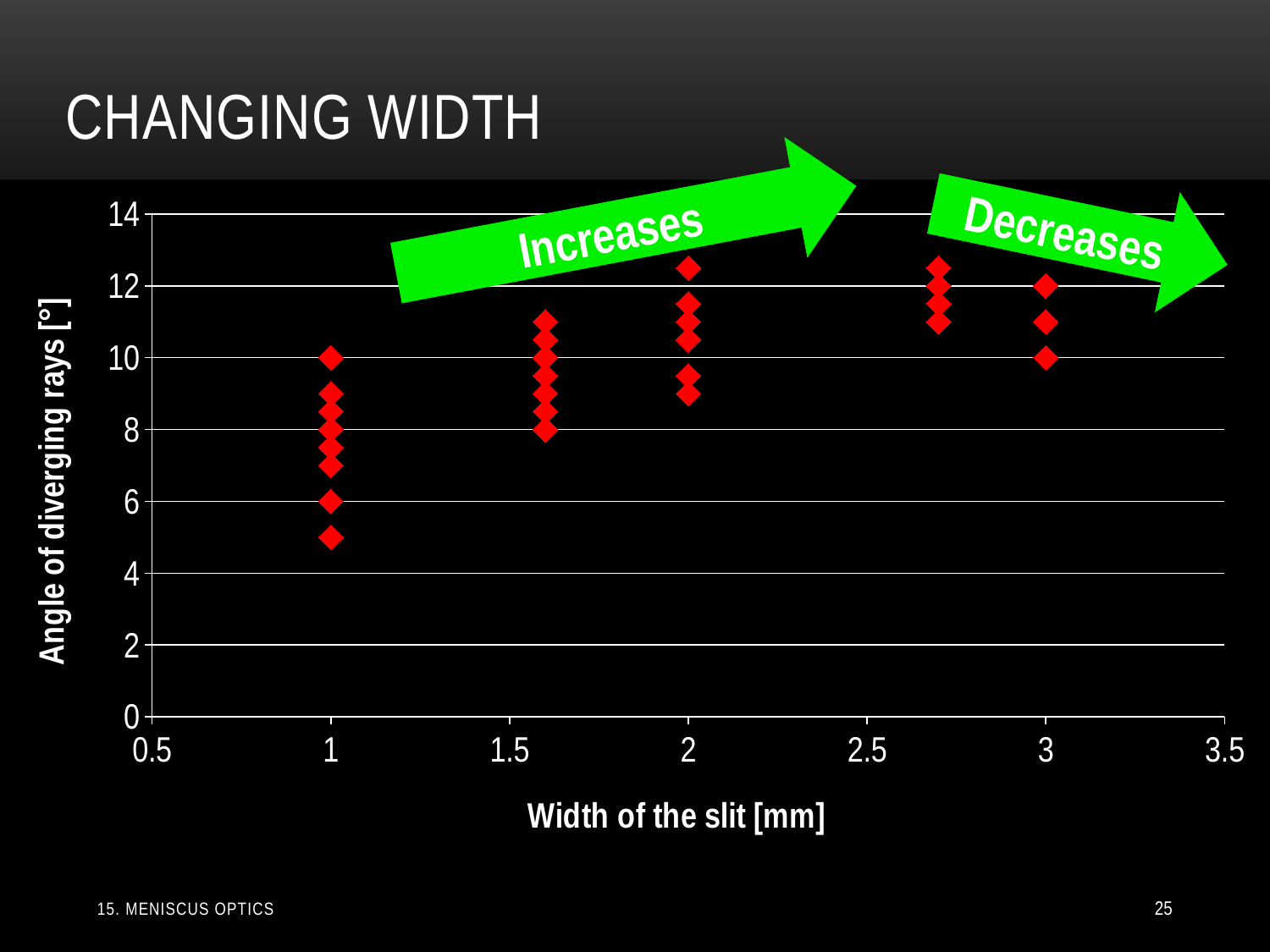
What is the title of the chart's x axis? Width of the slit [mm] Is the highest angle plotted at a slit width of 2 mm greater or less than 12? greater How many distinct slit widths have data points plotted? 5 Which slit width has the lowest plotted angle of diverging rays overall? 1 What kind of chart is shown on the slide? scatter chart Is the lowest angle plotted at a slit width of 3 mm greater or less than 8? greater What is the title of the chart's y axis? Angle of diverging rays [°] What is the highest angle of diverging rays plotted at a slit width of 3 mm? 12 What is the lowest angle of diverging rays plotted at a slit width of 3 mm? 10 What is the highest angle of diverging rays plotted at a slit width of 1 mm? 10 According to the arrows on the chart, how does the angle of diverging rays change as the slit width increases from 1 mm to 3 mm? It increases, then decreases Is the lowest angle plotted at a slit width of 1 mm greater or less than 6? less